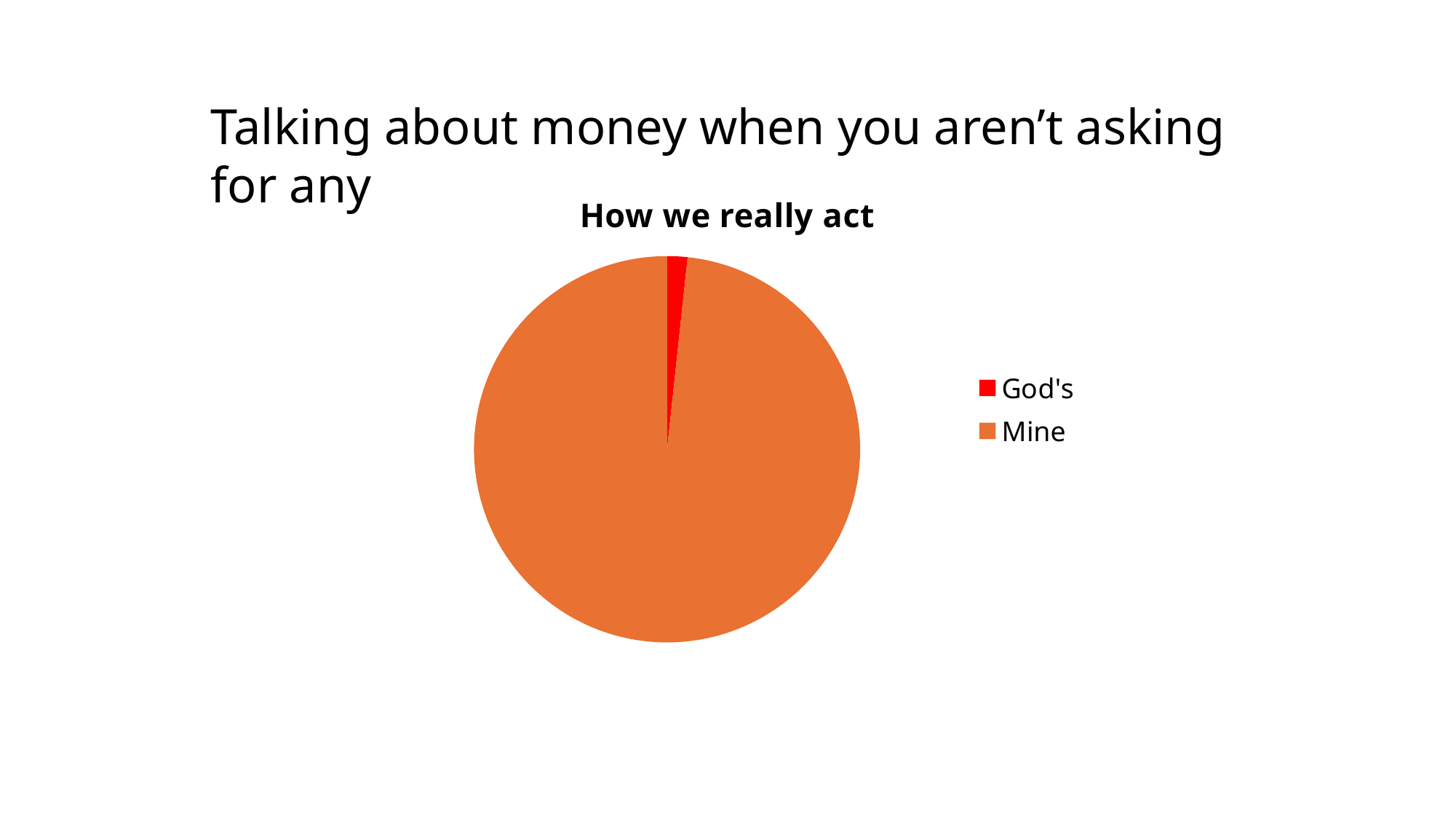
Which slice is the smallest in the pie chart? God's Which slice is the largest in the pie chart? Mine What colour is the slice for God's? red What is the title of the chart? How we really act How many entries does the legend list? 2 How many slices does the pie chart have? 2 Which slice is larger, God's or Mine? Mine What kind of chart is shown on the slide? pie chart